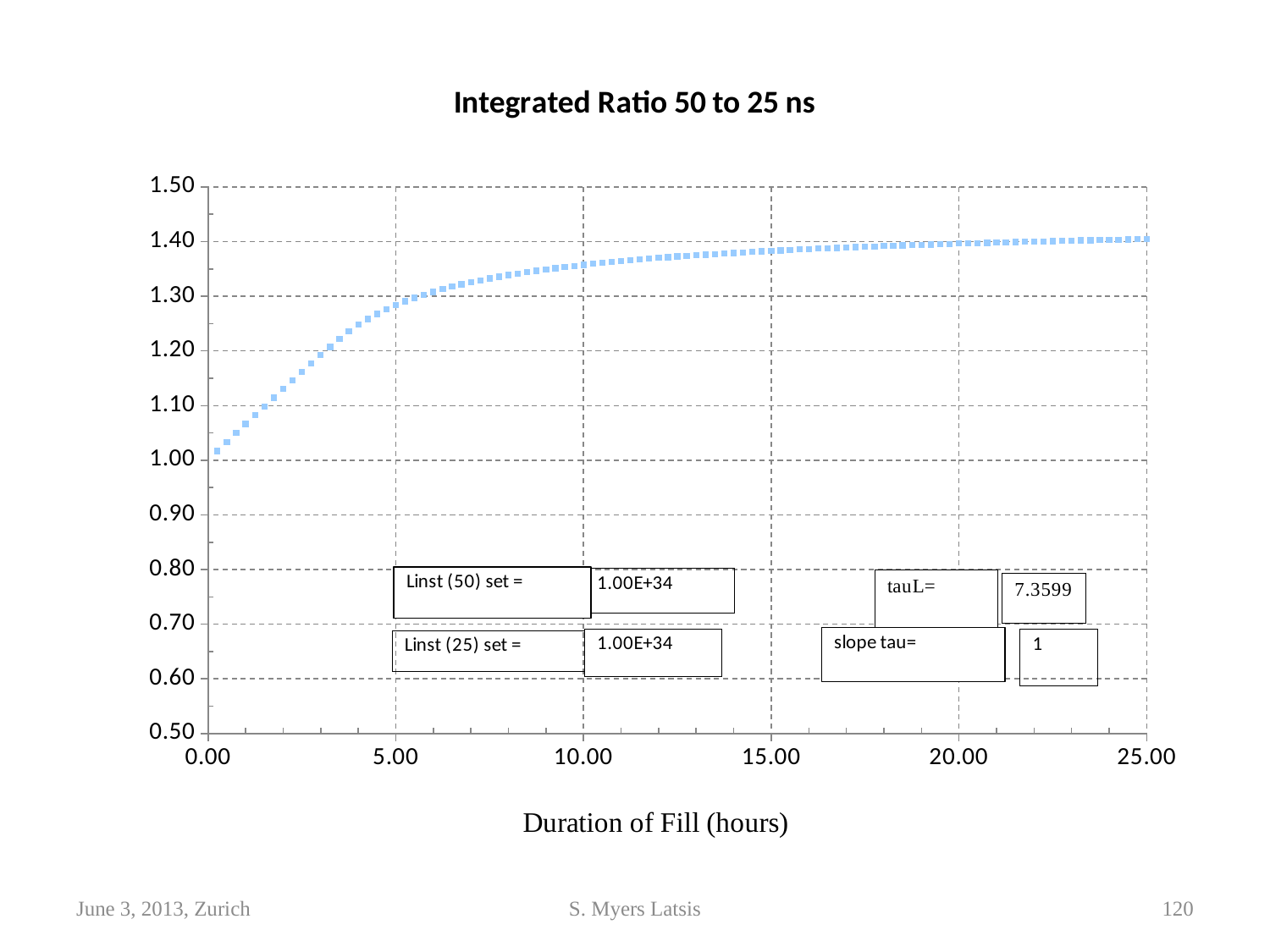
Is the value at a duration of 5.00 hours greater or less than 1.20? greater Is the value at a duration of 2.00 hours greater or less than 1.20? less What kind of chart is shown on the slide? scatter chart What value is given for tauL in the annotation box on the chart? 7.3599 Is the value at a duration of 25.00 hours greater or less than 1.50? less Is the value at 25.00 hours larger or smaller than the value at 5.00 hours? larger Does the integrated ratio rise or fall as the duration of fill increases? rise What is the title of the chart? Integrated Ratio 50 to 25 ns